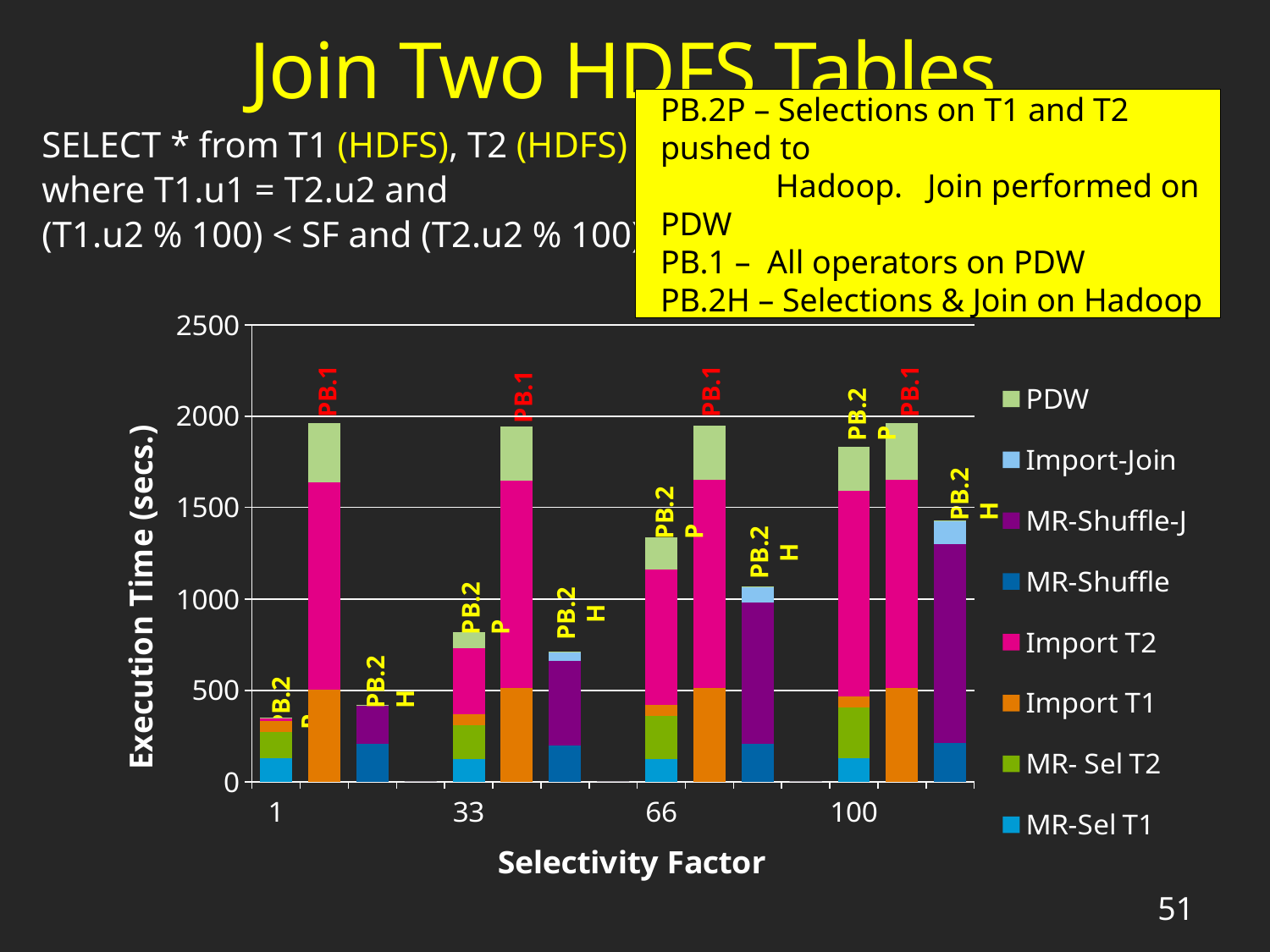
What is the title of the x axis? Selectivity Factor Is the total execution time for the PB.2P bar at selectivity factor 1 greater or less than 500? less What kind of chart is shown on the slide? Stacked bar chart How many selectivity factor categories are shown on the x axis? 4 Is the total execution time for the PB.2P bar at selectivity factor 100 greater or less than 1500? greater How many series does the legend list? 8 At selectivity factor 1, which of the three bars (PB.2P, PB.1, PB.2H) is the tallest? PB.1 What is the title of the y axis? Execution Time (secs.) At selectivity factor 66, which bar is taller, PB.2P or PB.2H? PB.2P Do the PB.2H bars rise or fall as the selectivity factor increases from 1 to 100? rise Is the total execution time for the PB.2H bar at selectivity factor 100 greater or less than 1000? greater